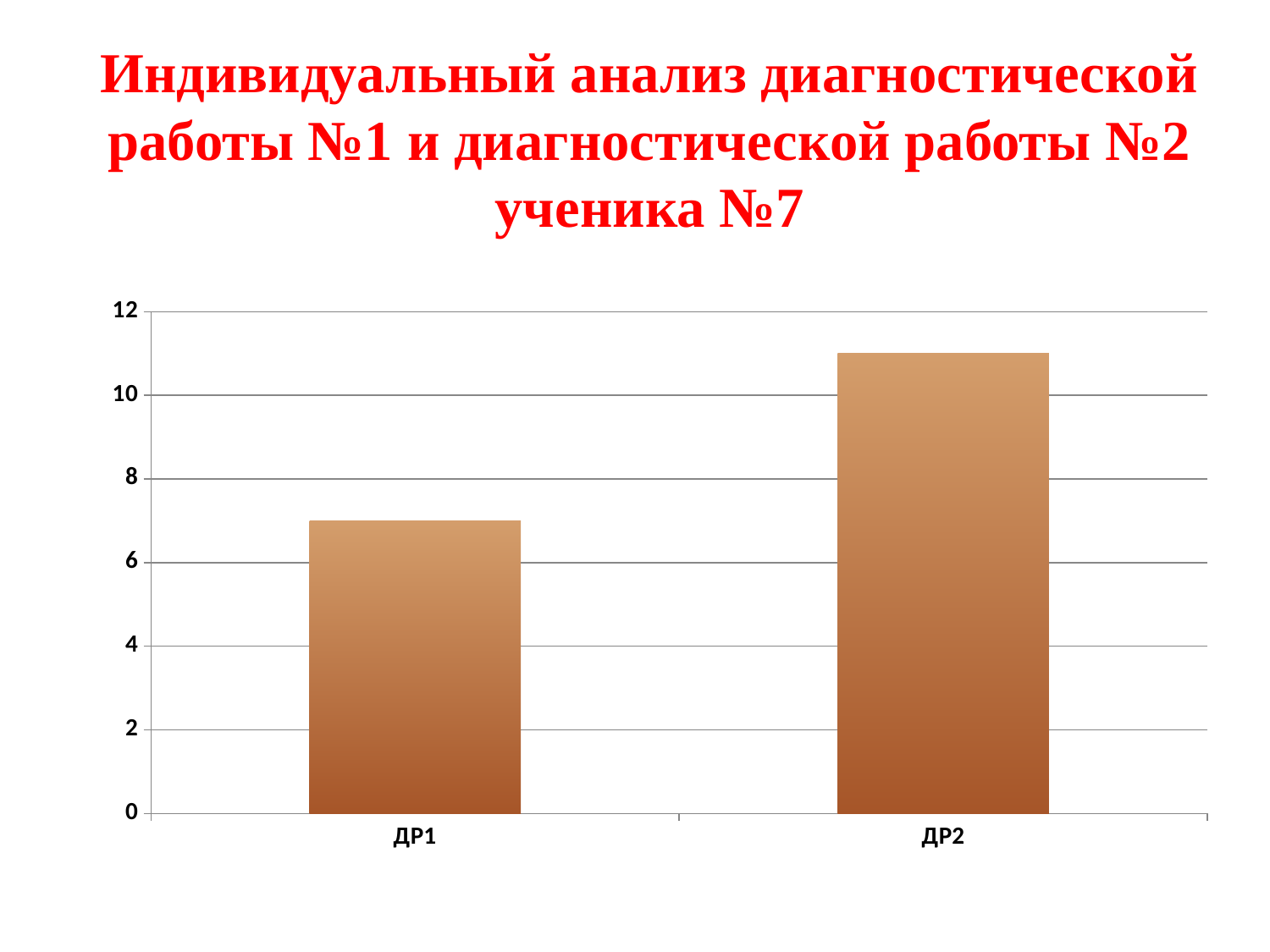
What is the maximum value shown on the vertical axis? 12 How many bars (categories) does the chart show? 2 Which is larger, the value for ДР1 or the value for ДР2? ДР2 Is the value for ДР2 greater or less than 10? greater What are the labels of the two categories on the horizontal axis? ДР1 and ДР2 Do the values rise or fall from ДР1 to ДР2? rise Is the value for ДР2 greater or less than 12? less What kind of chart is shown on the slide? bar chart Is the value for ДР1 greater or less than 8? less Which category has the lowest bar? ДР1 Which category has the highest bar? ДР2